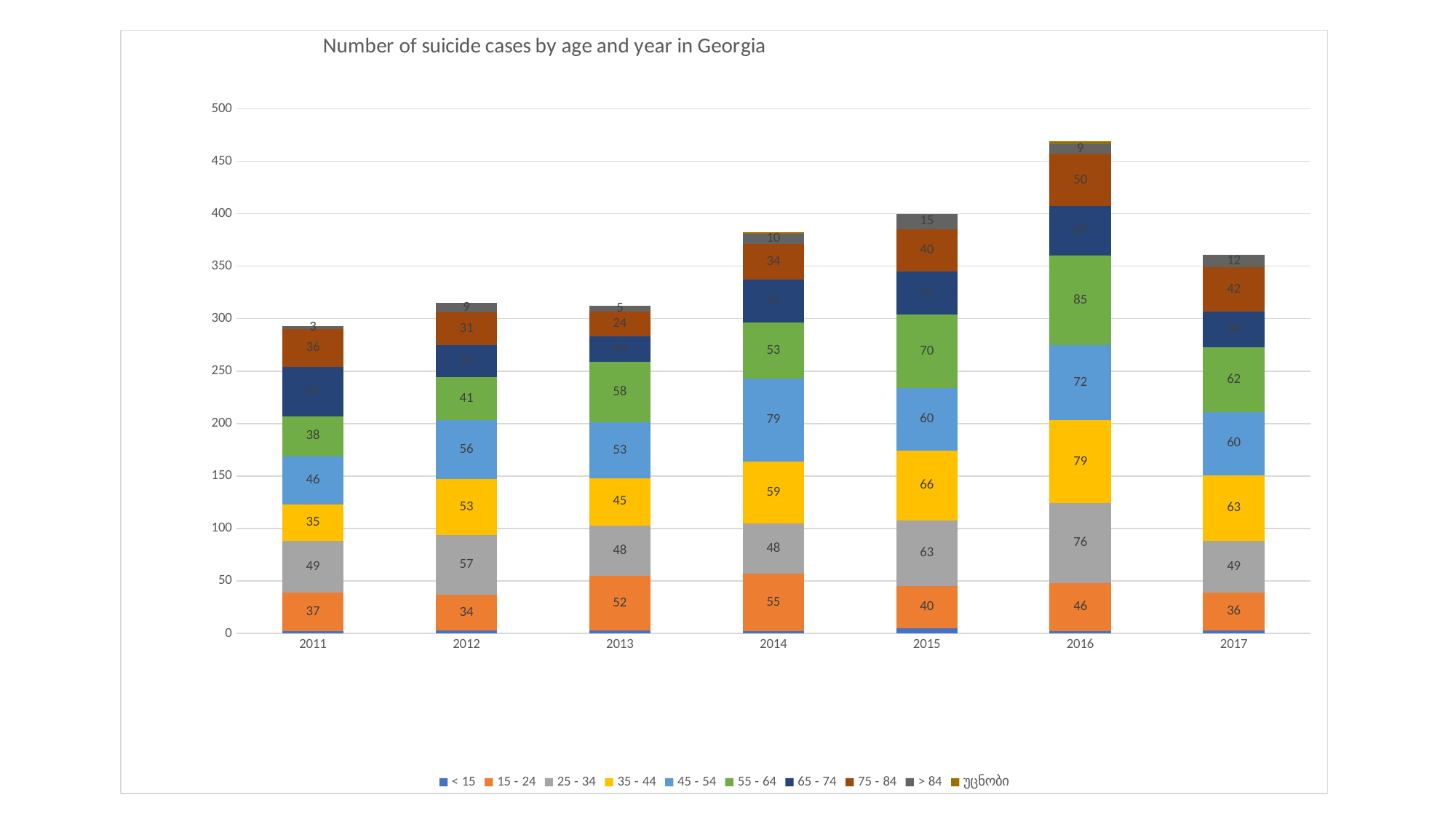
Is the total for 2016 greater or less than 450? greater How many years are shown on the x axis? 7 Which year has the shortest stacked bar overall? 2011 What type of chart is shown on the slide? Stacked bar chart What is the value for the 55 - 64 age group in 2016? 85 What is the value for the 45 - 54 age group in 2014? 79 What is the value for the > 84 age group in 2015? 15 Which is larger, the 25 - 34 value in 2015 or in 2012? 2015 What is the value for the 15 - 24 age group in 2013? 52 Which year has the tallest stacked bar overall? 2016 How many series does the legend list? 10 What is the difference between the 55 - 64 values in 2016 and 2011? 47